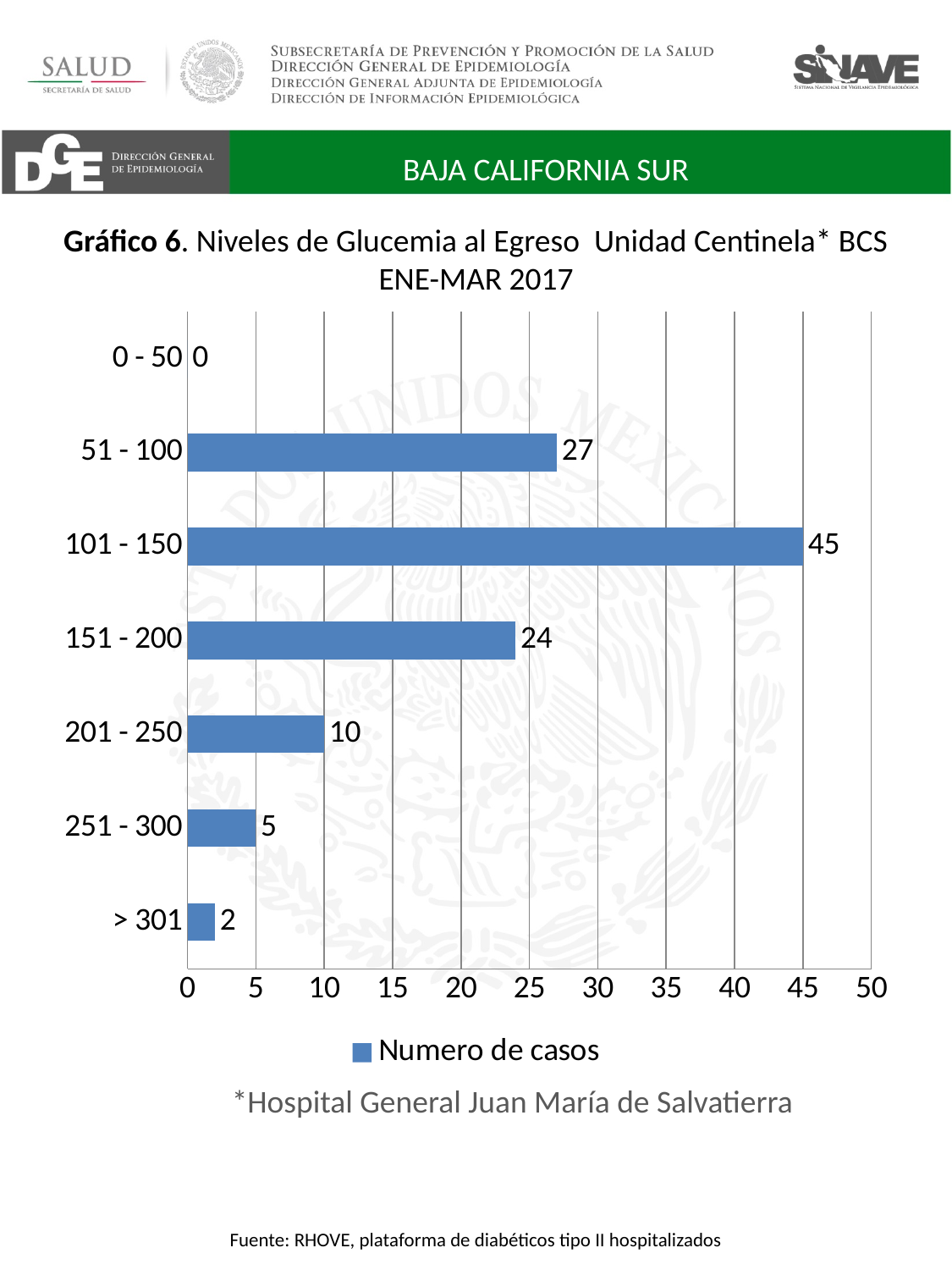
What is the number of cases for the 101 - 150 glucose level category? 45 What is the total number of cases across all categories? 113 What is the name of the series shown in the legend? Numero de casos What is the number of cases for the 51 - 100 category? 27 How many series does the legend list? 1 What is the number of cases for the > 301 category? 2 How many glucose level categories are shown on the chart? 7 Which category has more cases, 201 - 250 or 251 - 300? 201 - 250 Which glucose level category has the highest number of cases? 101 - 150 What kind of chart is shown on the slide? Bar chart Which glucose level category has the lowest number of cases? 0 - 50 What is the difference in number of cases between the 101 - 150 and 151 - 200 categories? 21